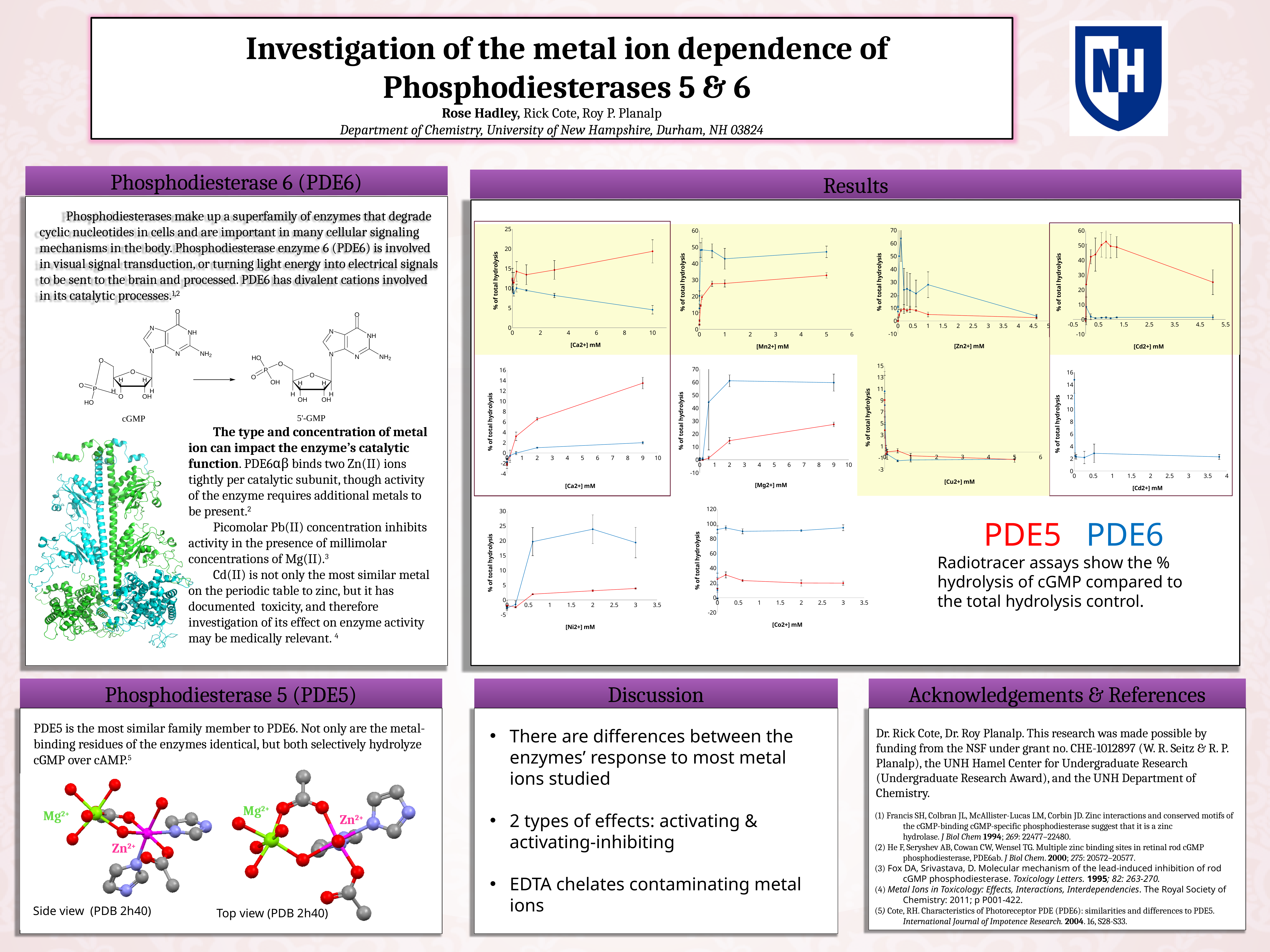
In the chart with x-axis [Co2+] mM, which series is higher at 3 mM, PDE5 (red) or PDE6 (blue)? PDE6 In the chart with x-axis [Mg2+] mM, is the PDE6 (blue) value at 9 mM greater or less than 50? greater In the top-right chart with x-axis [Cd2+] mM, which series is higher at 5 mM, PDE5 (red) or PDE6 (blue)? PDE5 In the chart with x-axis [Co2+] mM, is the PDE6 (blue) value at 3 mM greater or less than 80? greater In the chart with x-axis [Ni2+] mM, is the PDE6 (blue) value at 2 mM greater or less than 20? greater How many charts are shown in the Results section? 10 What kind of chart is the chart with x-axis [Ni2+] mM? line chart In the chart with x-axis [Mg2+] mM, does the PDE5 (red) line rise or fall as the Mg2+ concentration increases? rise How many series (enzymes) are plotted in the Results charts, according to the PDE5/PDE6 legend? 2